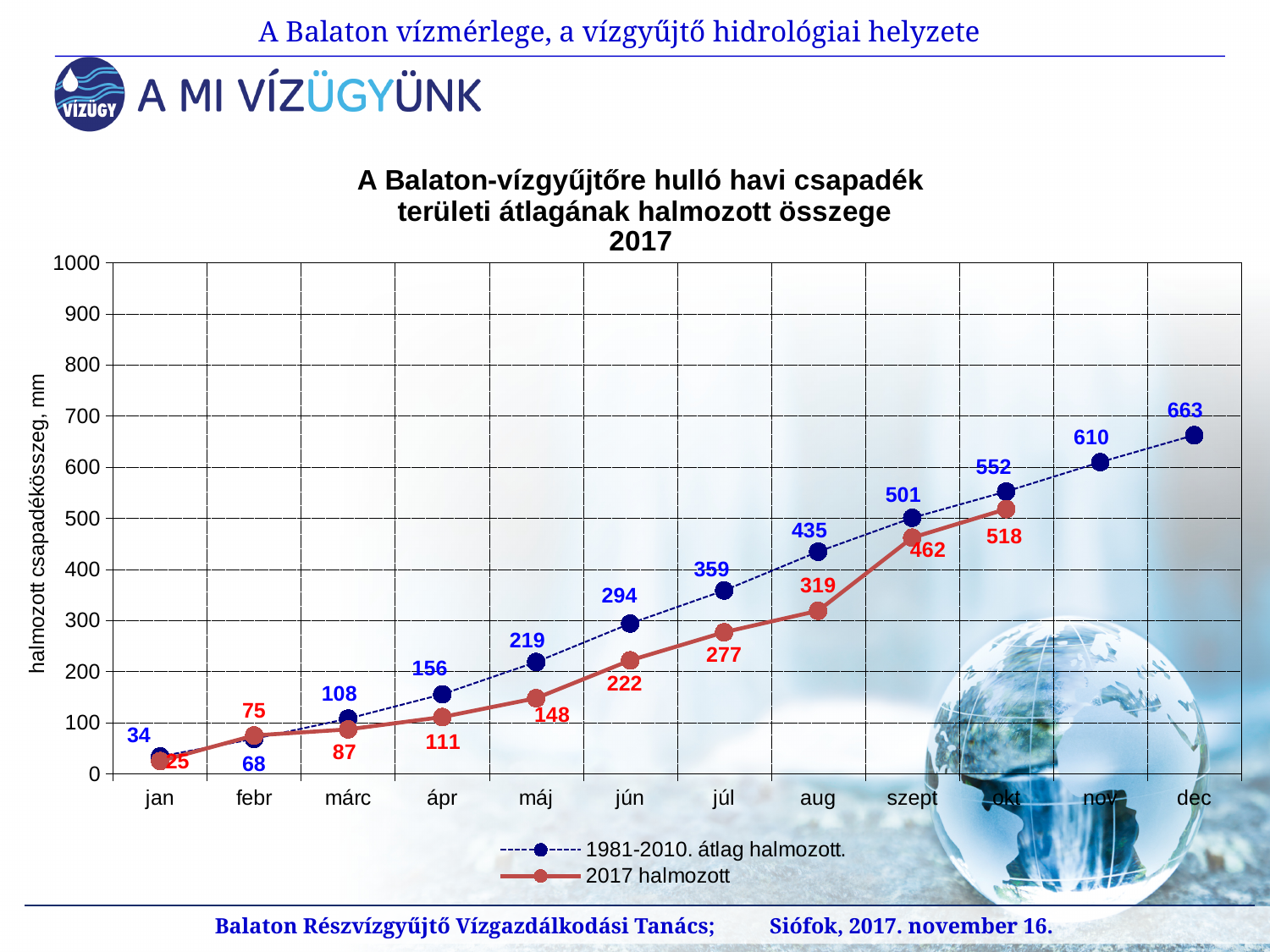
How many months are shown on the x axis? 12 Which month has the highest 2017 cumulative value shown? okt What kind of chart is shown on the slide? line chart Do the 2017 cumulative values rise or fall from jan to okt? rise Which series has the larger value for febr, the 1981-2010 average or 2017? 2017 halmozott What is the 1981-2010 average cumulative precipitation value for dec? 663 How many series does the legend list? 2 What is the 1981-2010 average cumulative value for aug? 435 Which month has the lowest 1981-2010 average cumulative value? jan What is the 2017 cumulative value for máj? 148 What is the 2017 cumulative precipitation value for okt? 518 What is the difference between the 1981-2010 average and the 2017 cumulative value for okt? 34